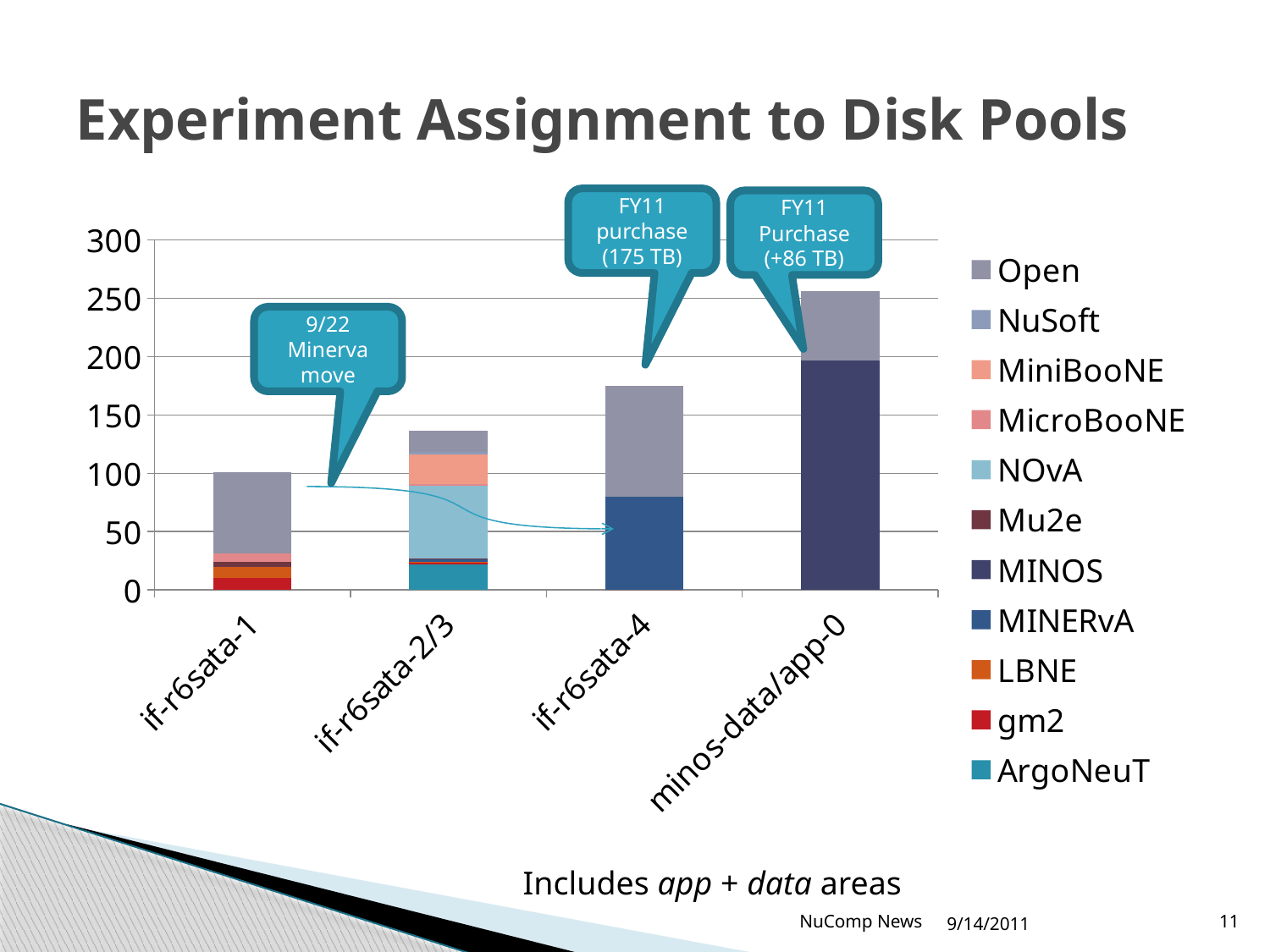
How many disk pool categories are shown on the x axis? 4 Which disk pool has the tallest stacked bar? minos-data/app-0 Which has a taller total bar, if-r6sata-4 or if-r6sata-2/3? if-r6sata-4 What is the title of the slide containing the chart? Experiment Assignment to Disk Pools Do the total bar heights rise or fall from left to right along the x axis? rise What does the callout pointing to the if-r6sata-4 bar say? FY11 purchase (175 TB) Is the total value for minos-data/app-0 greater or less than 200? greater Is the total value for if-r6sata-2/3 greater or less than 100? greater Which disk pool has the shortest stacked bar? if-r6sata-1 Is the total value for if-r6sata-1 greater or less than 150? less What kind of chart is shown on the slide? bar chart How many series does the legend list? 11